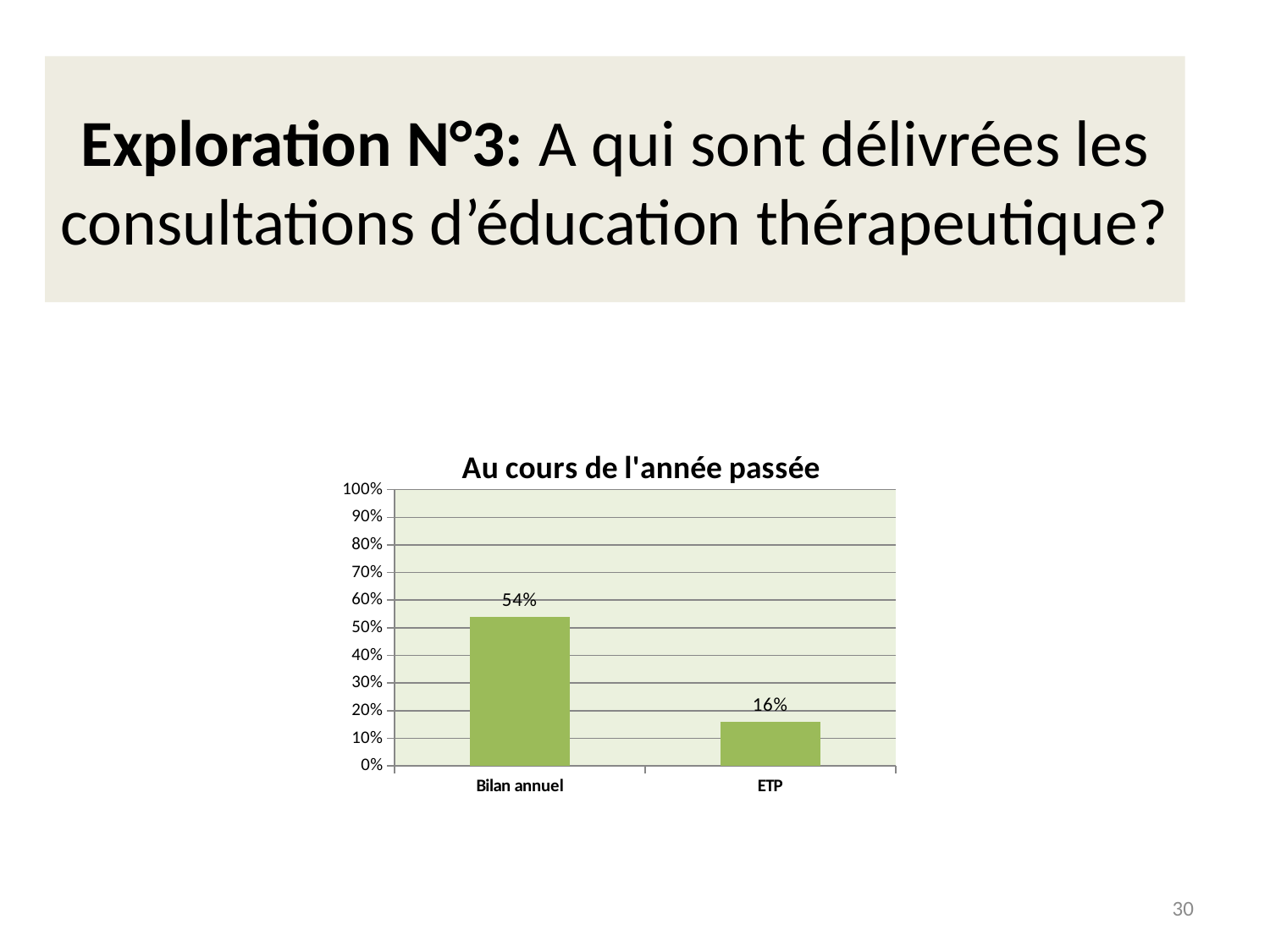
What is the difference between the values for Bilan annuel and ETP? 38% What is the value for ETP? 16% What is the value for Bilan annuel? 54% What is the highest value shown on the vertical axis? 100% Is the value for Bilan annuel greater or less than 50%? greater Is the value for ETP greater or less than 20%? less What kind of chart is shown on the slide? bar chart What is the title of the chart? Au cours de l'année passée Which category has the lowest value? ETP Which is larger, the value for Bilan annuel or the value for ETP? Bilan annuel How many categories are shown on the chart? 2 Which category has the highest value? Bilan annuel